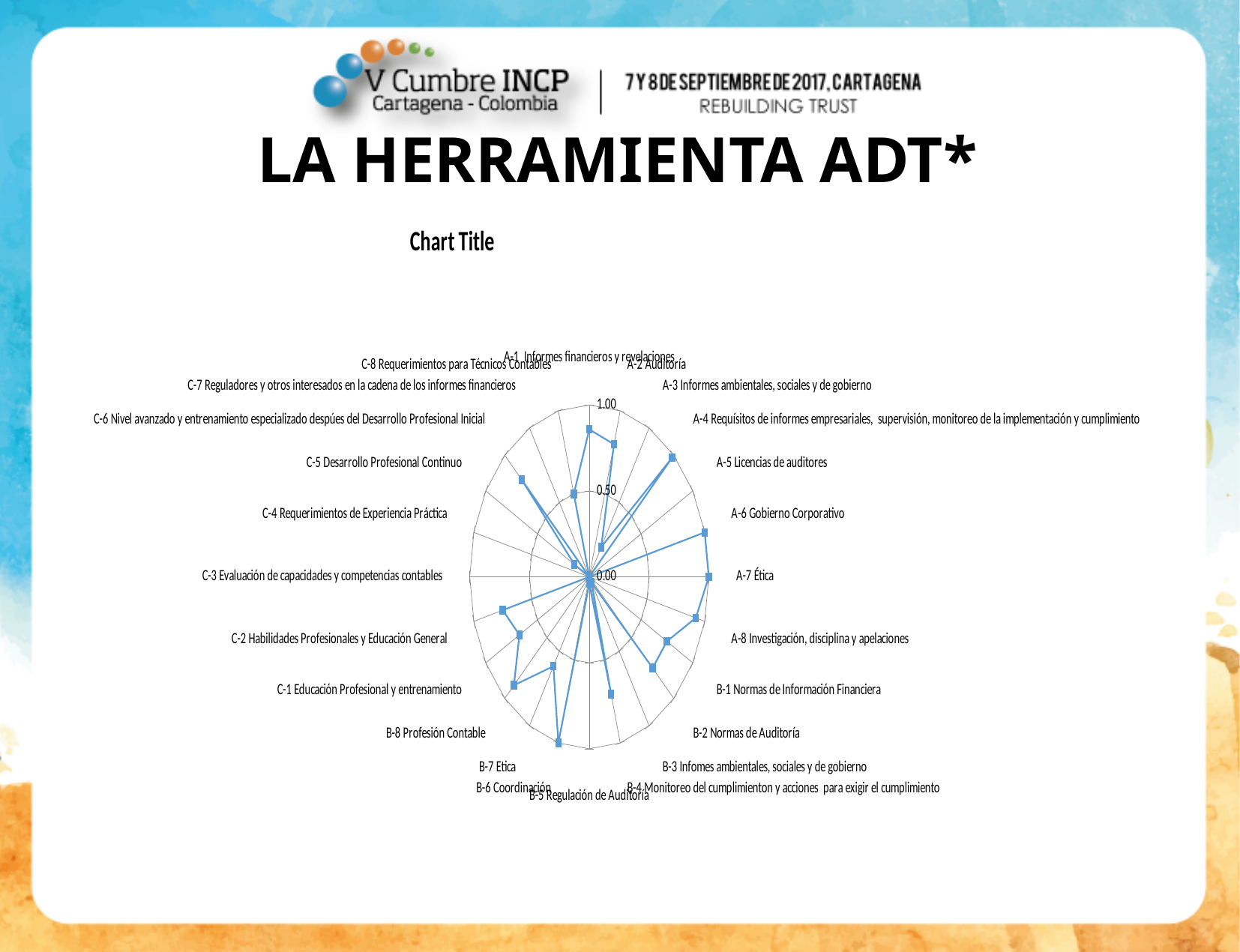
Which has the larger value, A-1 Informes financieros y revelaciones or A-7 Ética? A-7 Ética Is the value for A-1 Informes financieros y revelaciones greater or less than 0.50? greater Is the value for A-2 Auditoría greater or less than 0.50? greater Is the value for A-6 Gobierno Corporativo greater or less than 0.50? greater What kind of chart is shown on the slide? Radar chart What is the highest value labelled on the chart's radial axis? 1.00 What is the title shown above the chart? Chart Title How many categories (axes) does the radar chart have? 24